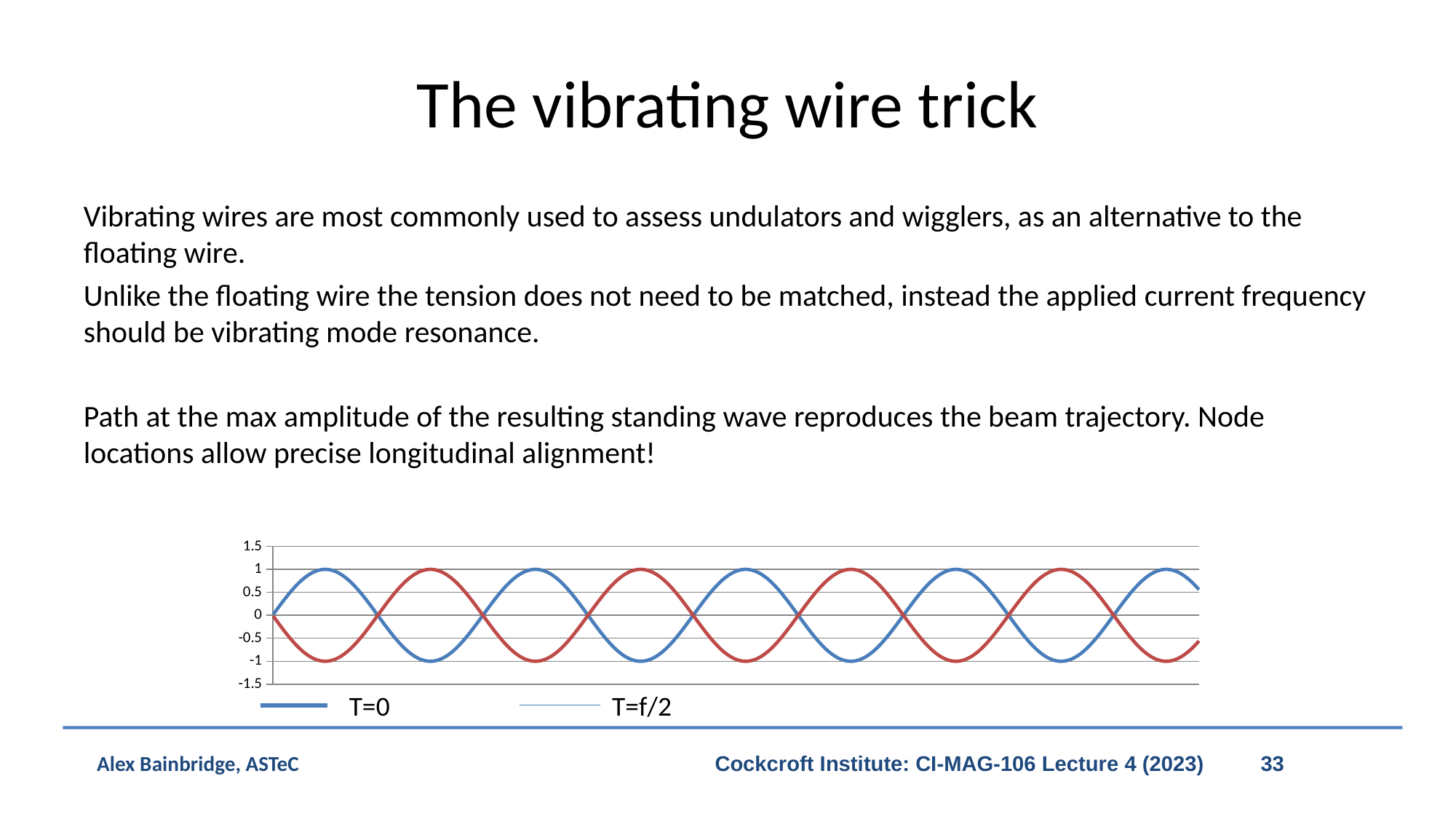
What colour is the T=0 line in the chart? blue What is the highest value shown on the chart's y axis? 1.5 How many series does the chart legend list? 2 Starting from the left edge of the chart, does the T=0 line initially rise or fall? rise What is the lowest value shown on the chart's y axis? -1.5 What is the maximum value reached by the T=0 line? 1 What kind of chart is shown on the slide? line chart How many peaks does the T=0 line reach across the chart? 5 What are the two series named in the chart legend? T=0 and T=f/2 Is the value of the T=f/2 line at its first trough greater or less than -0.5? less Is the value of the T=0 line at its first peak greater or less than 0.5? greater What is the minimum value reached by the T=f/2 line? -1